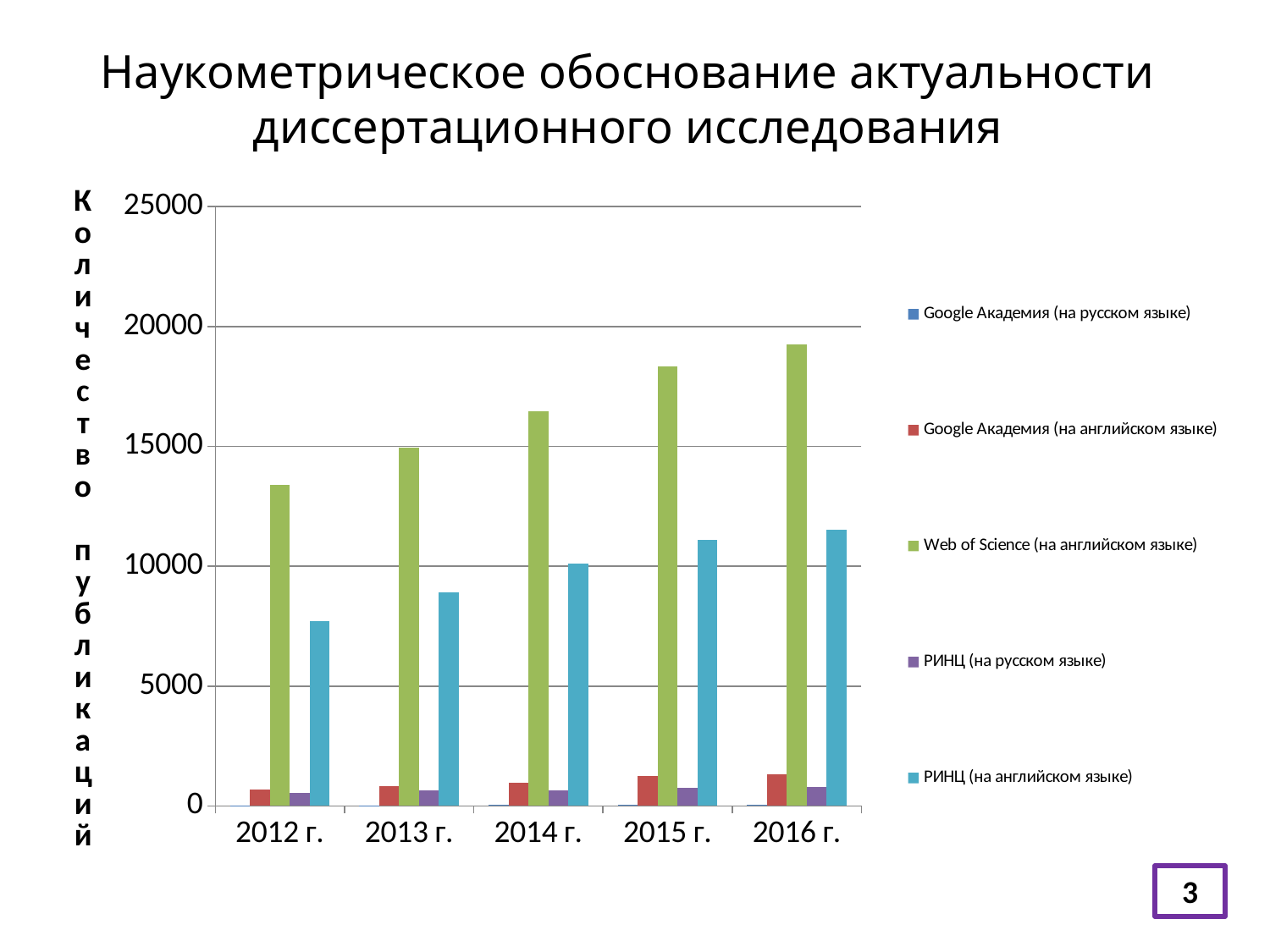
How many years are shown on the x axis? 5 Which is larger in 2015 г.: Web of Science (на английском языке) or РИНЦ (на английском языке)? Web of Science (на английском языке) How many series does the legend list? 5 Is the value for Web of Science (на английском языке) in 2012 г. greater or less than 15000? less In which year is the value for Web of Science (на английском языке) highest? 2016 г. Is the value for Web of Science (на английском языке) in 2016 г. greater or less than 15000? greater What is the label of the vertical axis? Количество публикаций What kind of chart is shown on the slide? bar chart In which year is the value for Web of Science (на английском языке) lowest? 2012 г. Is the value for РИНЦ (на английском языке) in 2016 г. greater or less than 10000? greater Do the values for РИНЦ (на английском языке) rise or fall from 2012 г. to 2016 г.? rise